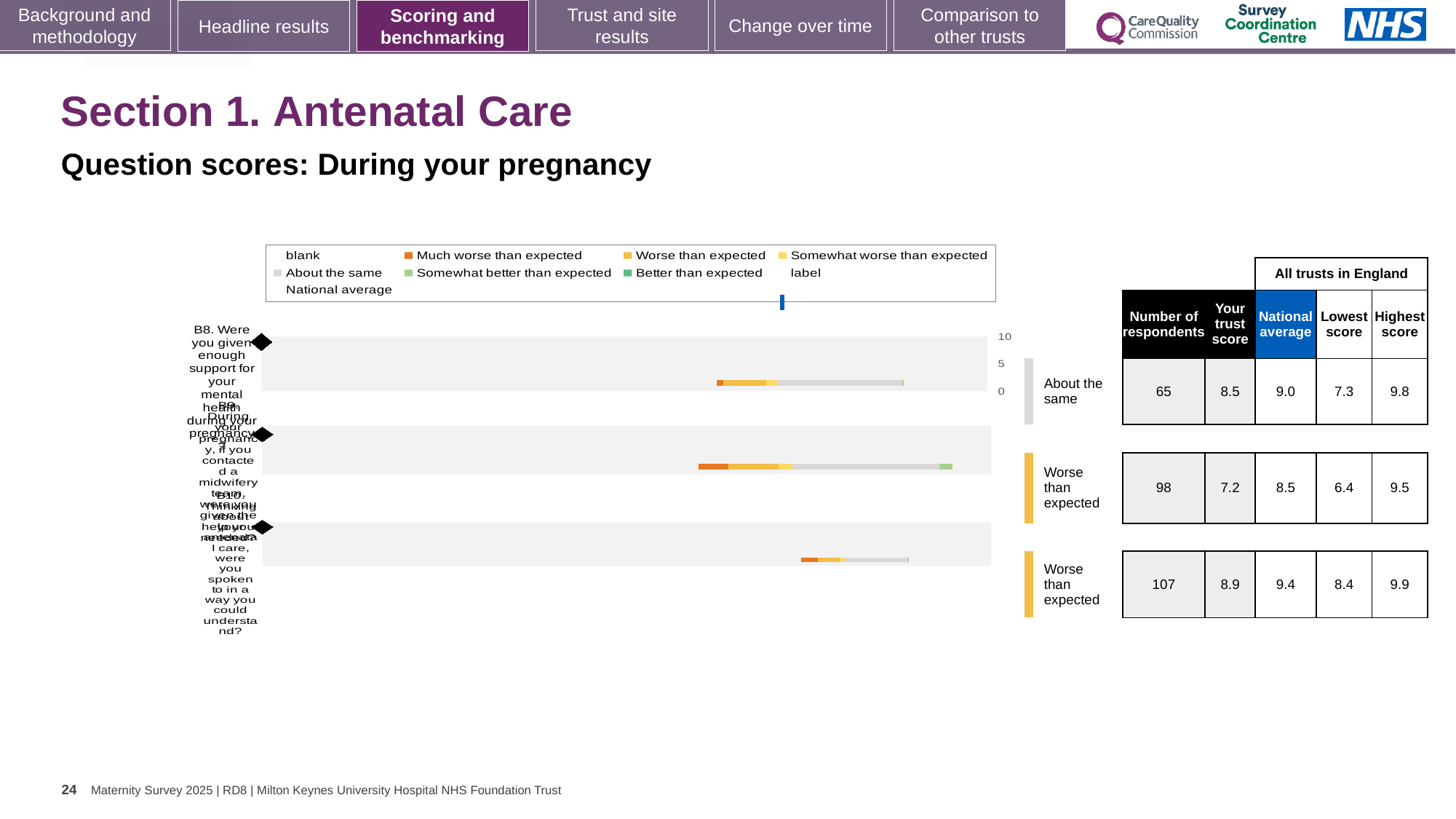
What is the benchmark category shown for the second question row? Worse than expected What is the trust score for the first question row (B8, support for your mental health)? 8.5 How many question rows are plotted in the chart? 3 What colour in the legend represents 'Much worse than expected'? orange What kind of chart is shown on the slide? bar chart Which is larger for the third question row: the trust score or the national average? the national average What is the national average for the second question row? 8.5 What colour in the legend represents 'Better than expected'? green What is the difference between the national average and the trust score for the second question row? 1.3 Which question row has the lowest trust score? the second row What is the number of respondents for the third question row? 107 What is the benchmark category shown for the first question row (B8, support for your mental health)? About the same